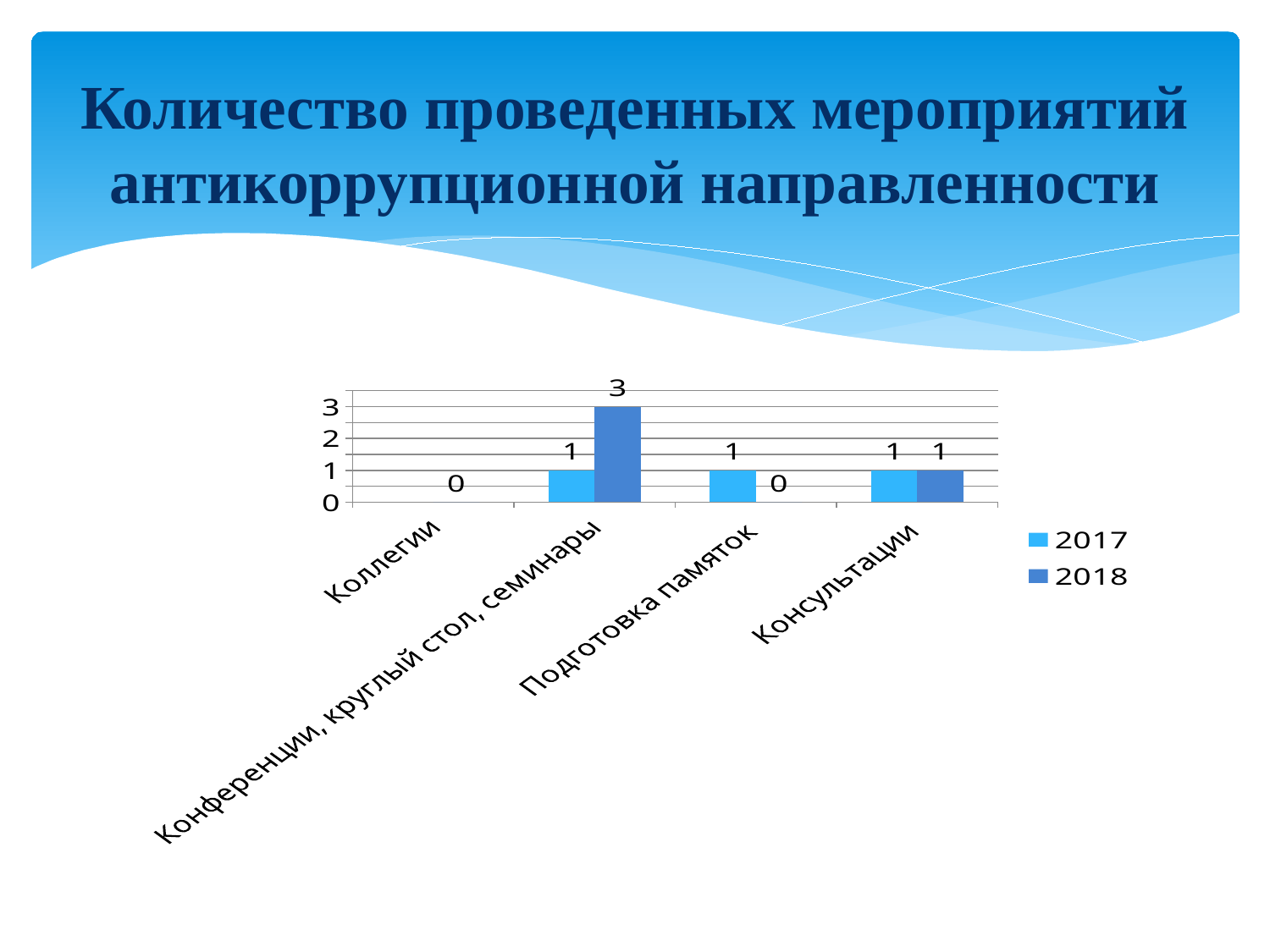
Which category has the highest value for 2018? Конференции, круглый стол, семинары For "Подготовка памяток", which series has the larger value, 2017 or 2018? 2017 What is the value for 2017 in the category "Консультации"? 1 What are the entries listed in the legend? 2017, 2018 What is the value for 2017 in the category "Конференции, круглый стол, семинары"? 1 How many categories are shown on the x axis? 4 What is the value for 2018 in the category "Коллегии"? 0 What kind of chart is shown on the slide? bar chart What is the value for 2018 in the category "Подготовка памяток"? 0 What is the value for 2018 in the category "Конференции, круглый стол, семинары"? 3 How many series does the legend list? 2 What is the difference between the 2018 and 2017 values for "Конференции, круглый стол, семинары"? 2